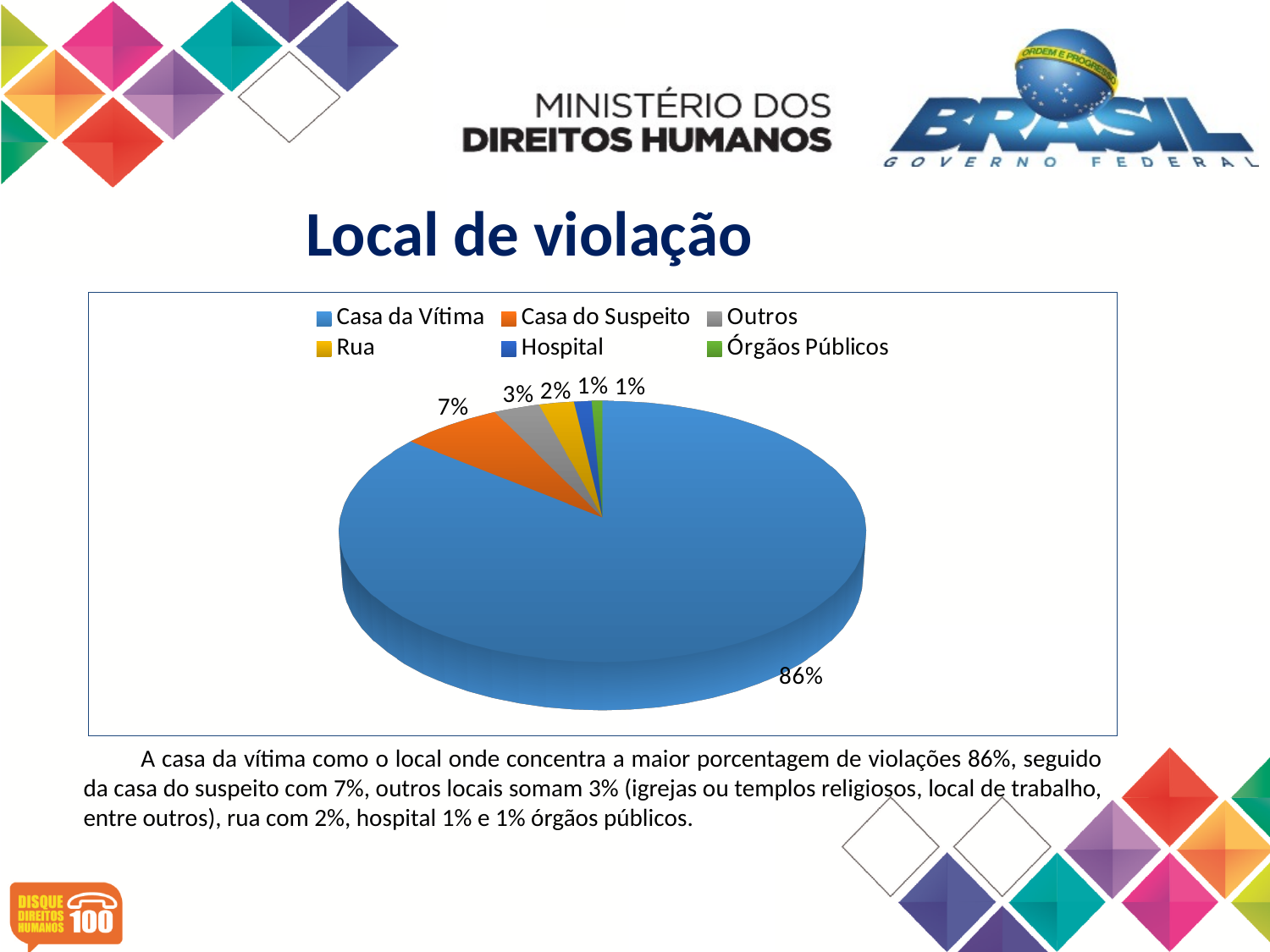
Which is larger, the slice for Outros or the slice for Rua? Outros Which category has the largest slice of the pie chart? Casa da Vítima What is the title of the slide containing the chart? Local de violação What percentage of the pie chart does Casa do Suspeito represent? 7% What percentage of the pie chart does Outros represent? 3% What kind of chart is shown on the slide? Pie chart What is the combined percentage of Hospital and Órgãos Públicos? 2% What percentage of the pie chart does Casa da Vítima represent? 86% What colour is the slice for Casa do Suspeito? Orange How many categories does the pie chart show? 6 What percentage of the pie chart does Rua represent? 2% What is the difference in percentage points between Casa da Vítima and Casa do Suspeito? 79